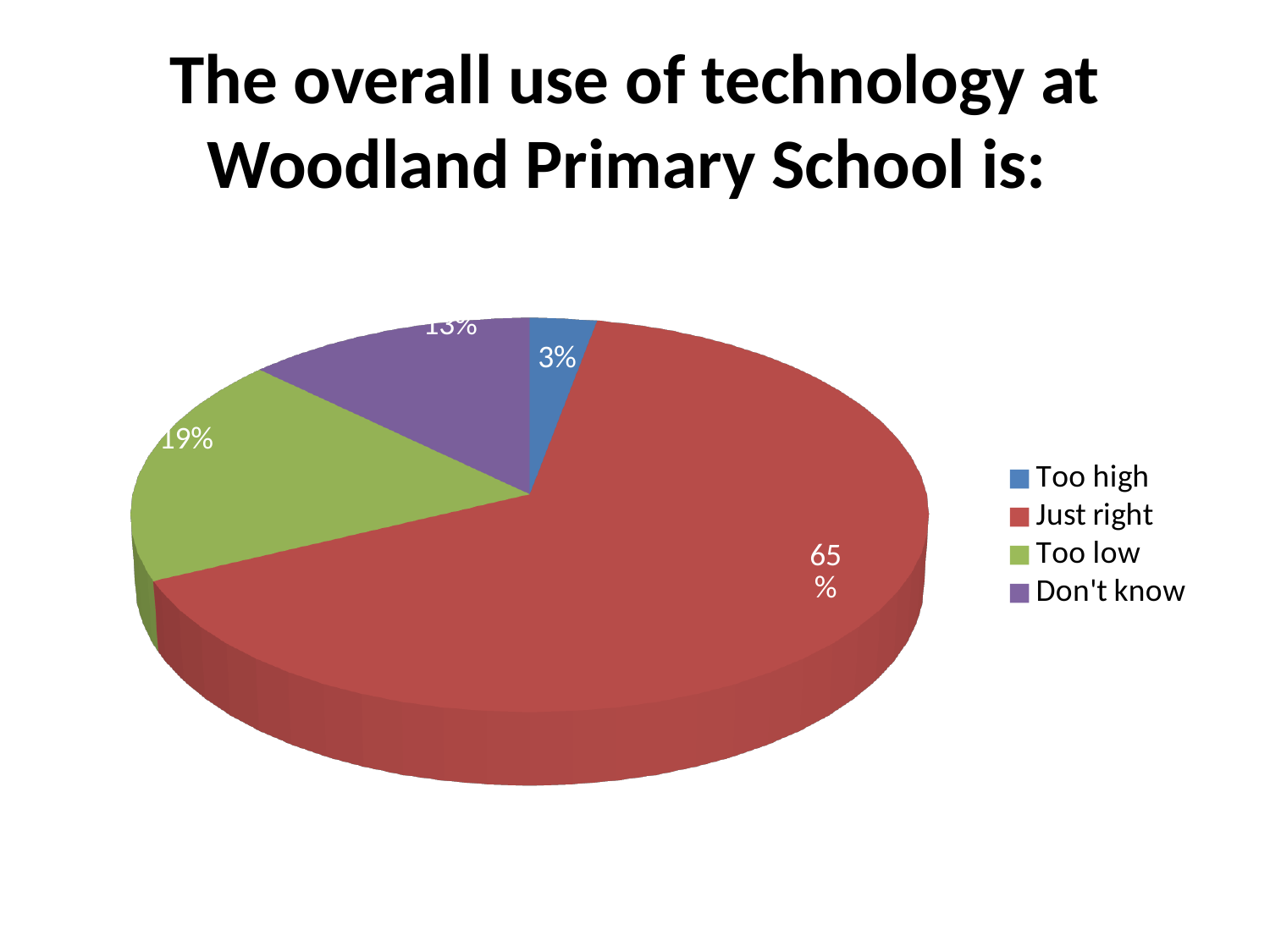
What colour is the 'Just right' slice? red What percentage of respondents said the use of technology is 'Too high'? 3% Which is larger, the share for 'Too low' or the share for 'Don't know'? Too low Which response has the largest share of the pie? Just right What kind of chart is shown on the slide? pie chart How many entries does the legend list? 4 Which response has the smallest share of the pie? Too high What percentage of respondents answered 'Don't know'? 13% What is the difference in percentage points between 'Just right' and 'Too low'? 46 How many slices does the pie chart have? 4 What percentage of respondents said the use of technology is 'Just right'? 65% What percentage of respondents said the use of technology is 'Too low'? 19%